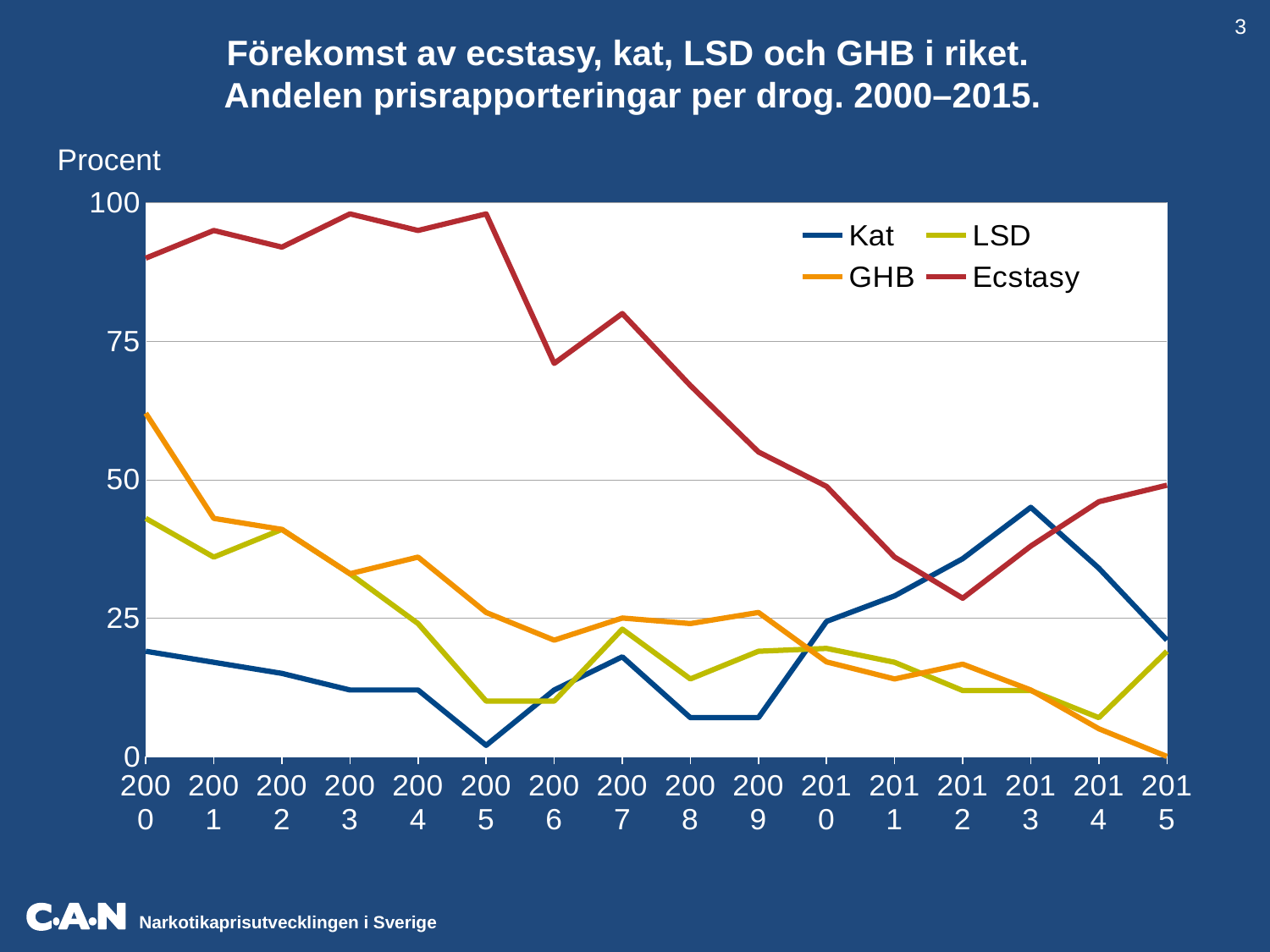
What kind of chart is shown on the slide? line chart Which series has the highest value in 2000? Ecstasy What colour is the Ecstasy line in the legend? red How many series does the legend list? 4 Is the value for GHB in 2000 greater or less than 50? greater Which series has the lowest value in 2015? GHB In 2013, which is larger, the value for Kat or the value for Ecstasy? Kat Is the value for Ecstasy in 2000 greater or less than 75? greater Is the value for Kat in 2005 greater or less than 25? less Does the Ecstasy line rise or fall from 2005 to 2011? fall How many years are plotted along the x axis? 16